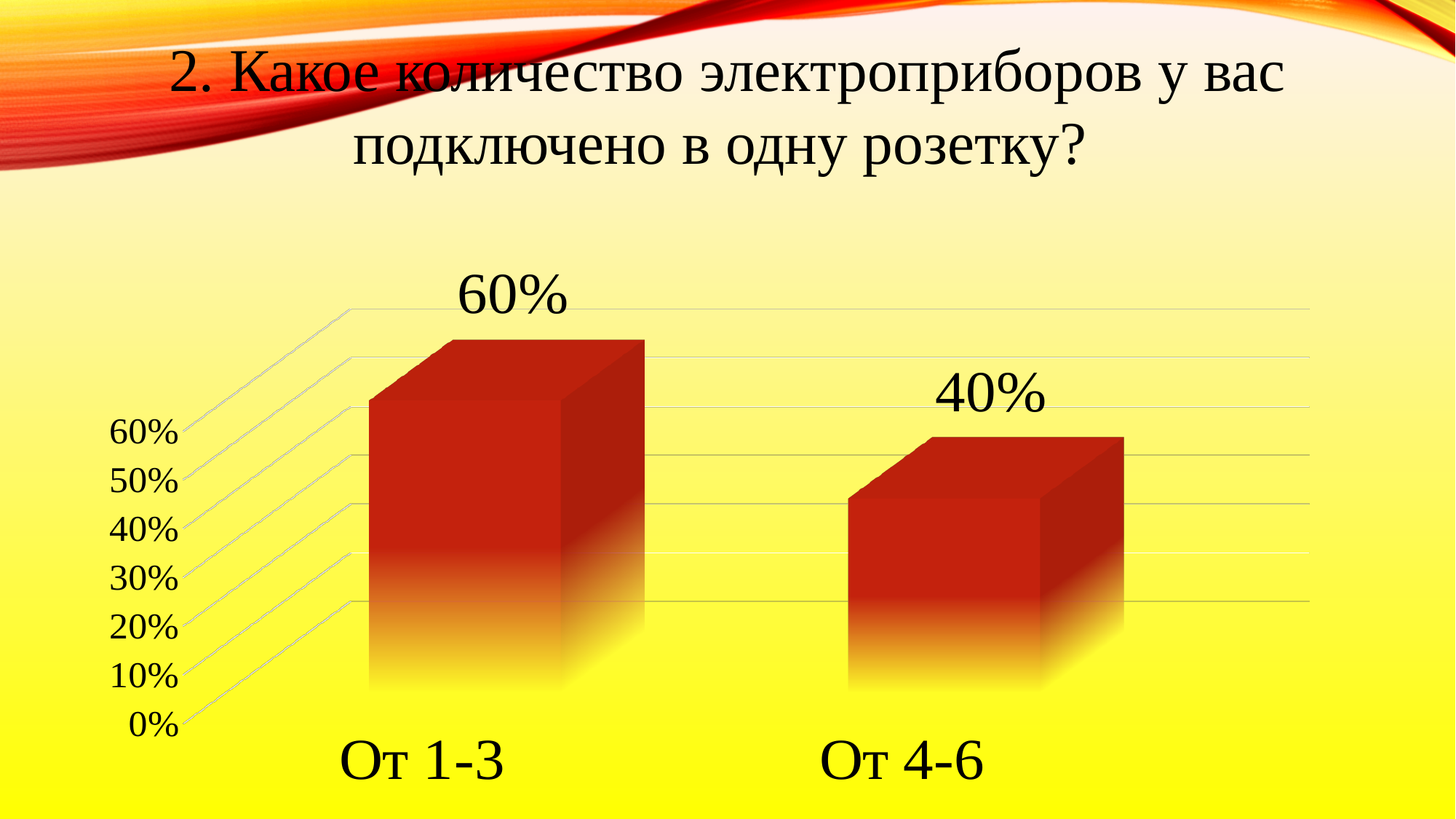
Is the value for "От 4-6" greater or less than 50%? less Is the value for "От 1-3" greater or less than 50%? greater How many categories are shown on the chart? 2 What is the difference between the values for "От 1-3" and "От 4-6"? 20% Which category has the highest value? От 1-3 Which category has the lowest value? От 4-6 What is the value for the category "От 4-6"? 40% Do the values rise or fall from left to right along the x axis? fall What kind of chart is shown on the slide? bar chart What is the highest tick label shown on the vertical axis? 60% Which is larger, the value for "От 1-3" or the value for "От 4-6"? От 1-3 What is the value for the category "От 1-3"? 60%